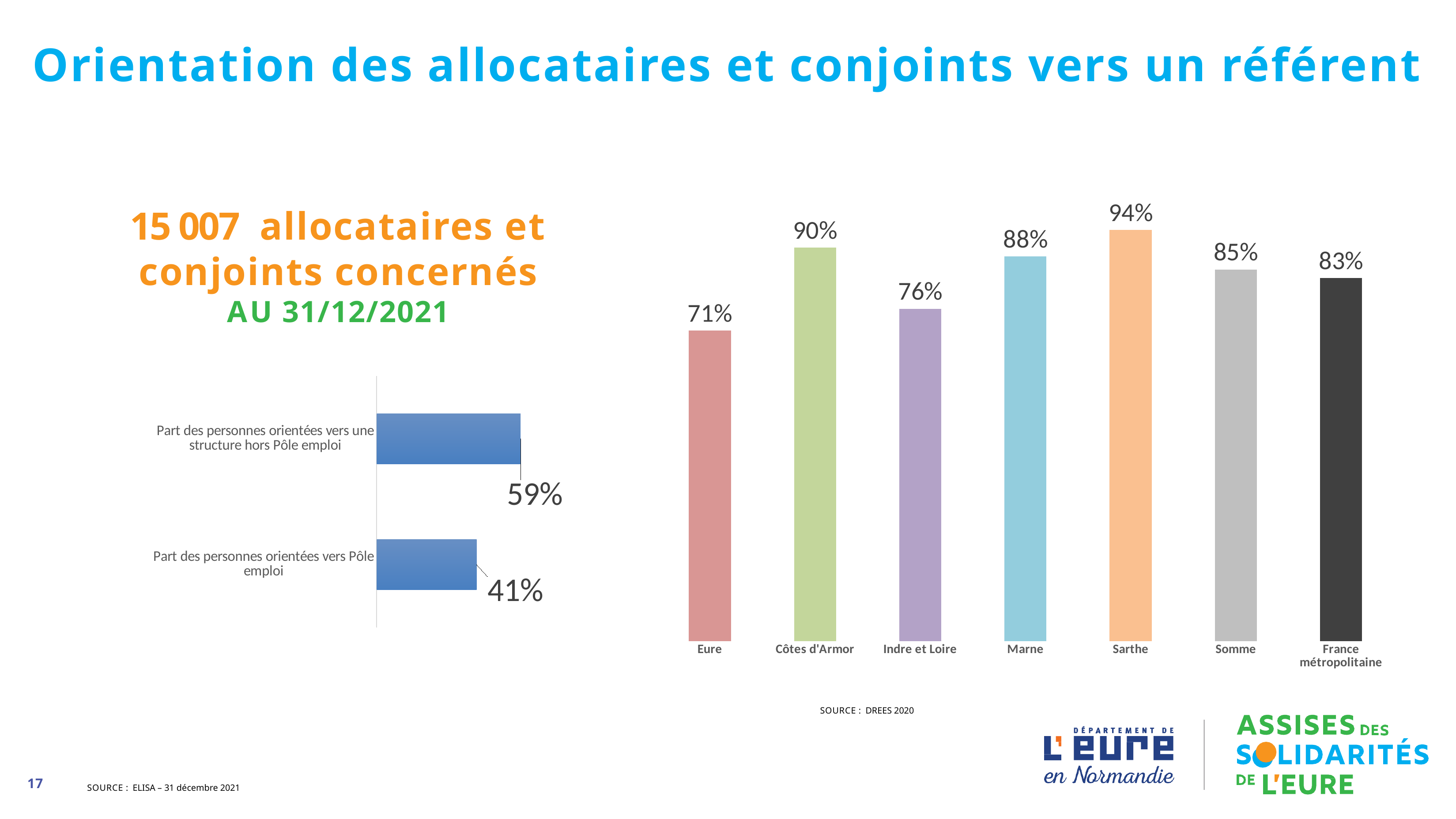
In the bar chart on the right, what is the value for France métropolitaine? 83% In the bar chart on the left, what is the value for 'Part des personnes orientées vers Pôle emploi'? 41% What kind of chart is shown on the left of the slide? Bar chart In the bar chart on the right, which category has the highest value? Sarthe In the bar chart on the left, what is the value for 'Part des personnes orientées vers une structure hors Pôle emploi'? 59% In the bar chart on the right, which is larger, the value for Marne or the value for Somme? Marne In the bar chart on the right, what is the value for Sarthe? 94% In the bar chart on the left, what is the difference between the two values shown? 18% In the bar chart on the right, what is the value for Eure? 71% In the bar chart on the right, which category has the lowest value? Eure In the bar chart on the right, what is the difference between the values for Côtes d'Armor and Indre et Loire? 14% How many categories are shown in the bar chart on the right? 7